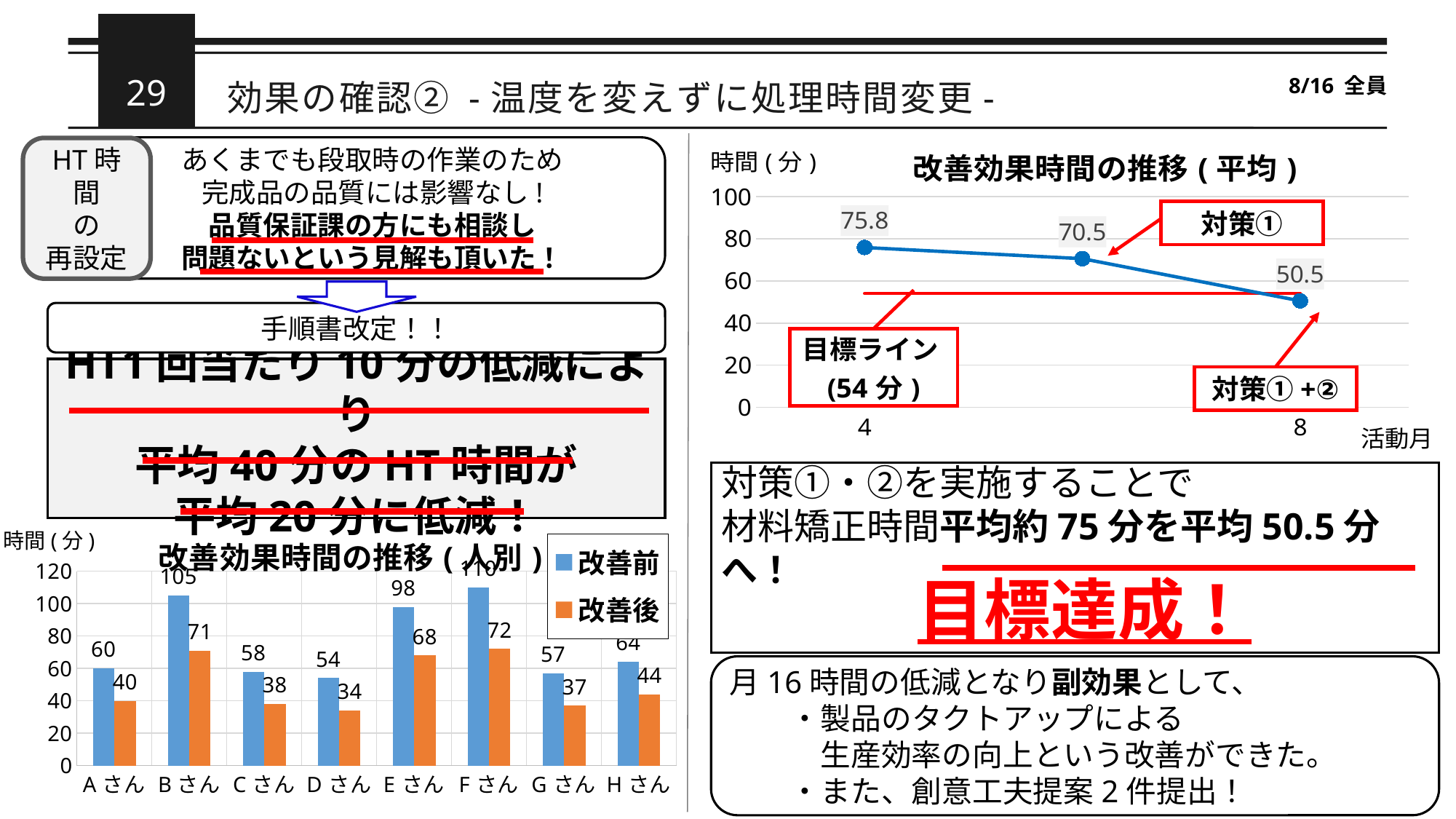
In the bar chart titled 改善効果時間の推移（人別）, which person has the highest 改善前 value? Fさん In the line chart titled 改善効果時間の推移（平均）, what is the value of the last data point (at 活動月 8)? 50.5 In the line chart titled 改善効果時間の推移（平均）, how many data points are plotted? 3 In the bar chart titled 改善効果時間の推移（人別）, what is the 改善前 value for Fさん? 110 In the bar chart titled 改善効果時間の推移（人別）, how many series does the legend list? 2 In the bar chart titled 改善効果時間の推移（人別）, what is the 改善後 value for Dさん? 34 In the bar chart titled 改善効果時間の推移（人別）, what is the difference between the 改善前 and 改善後 values for Bさん? 34 In the line chart titled 改善効果時間の推移（平均）, what is the difference between the first value (75.8) and the last value (50.5)? 25.3 In the line chart titled 改善効果時間の推移（平均）, do the values rise or fall from left to right? fall In the line chart titled 改善効果時間の推移（平均）, what is the value of the first data point? 75.8 In the bar chart titled 改善効果時間の推移（人別）, which person has the lowest 改善後 value? Dさん What kind of chart is the one titled 改善効果時間の推移（人別）? bar chart